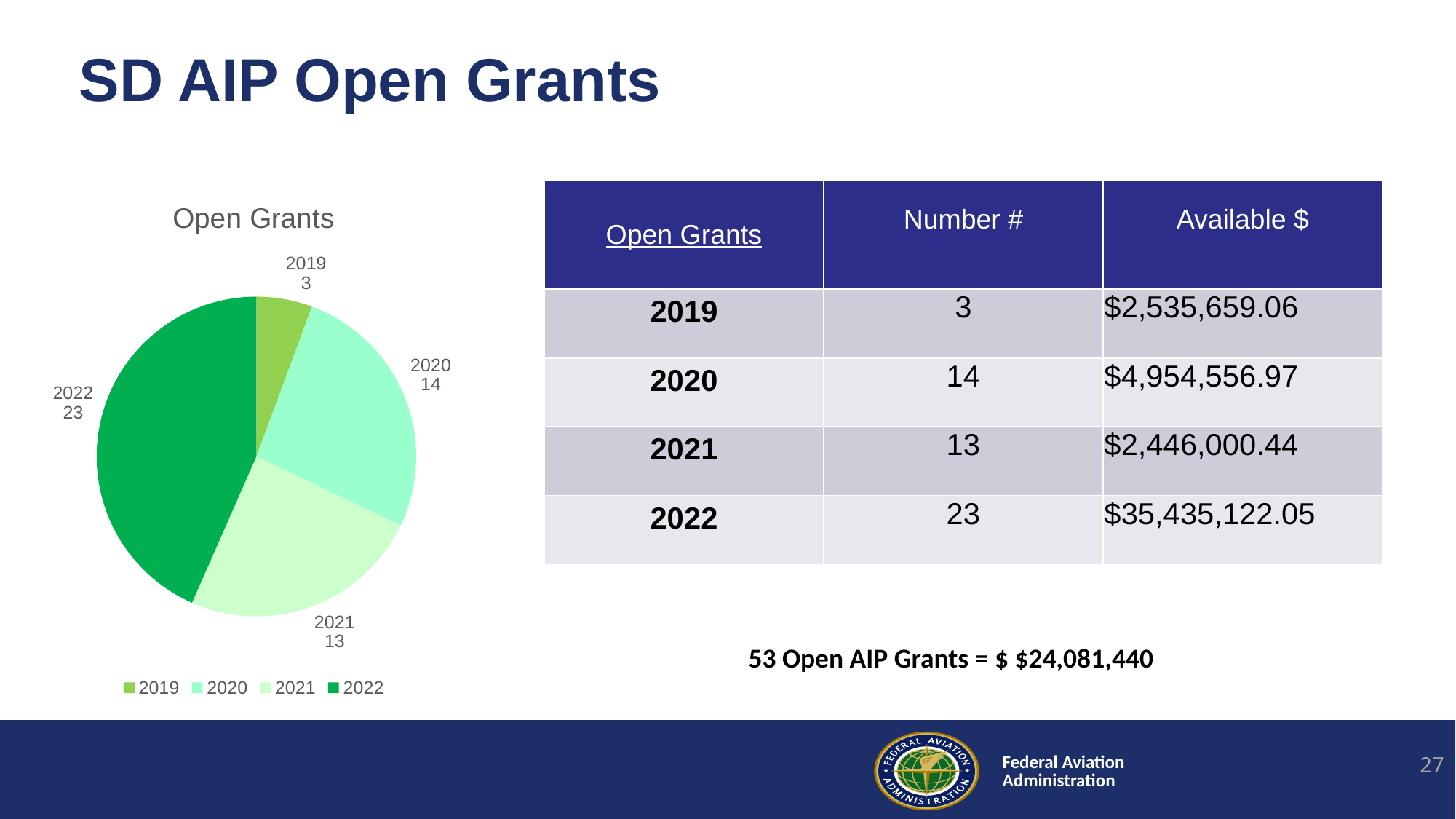
What is the value shown for 2021 in the pie chart? 13 Which year has the smallest slice in the pie chart? 2019 What is the value shown for 2019 in the pie chart? 3 What is the title of the chart? Open Grants Which has the larger value in the pie chart, 2020 or 2021? 2020 What is the value shown for 2022 in the pie chart? 23 Which year has the largest slice in the pie chart? 2022 What type of chart is shown on the slide? Pie chart How many slices does the pie chart have? 4 What is the value shown for 2020 in the pie chart? 14 What is the difference between the values for 2022 and 2019 in the pie chart? 20 How many entries does the chart legend list? 4